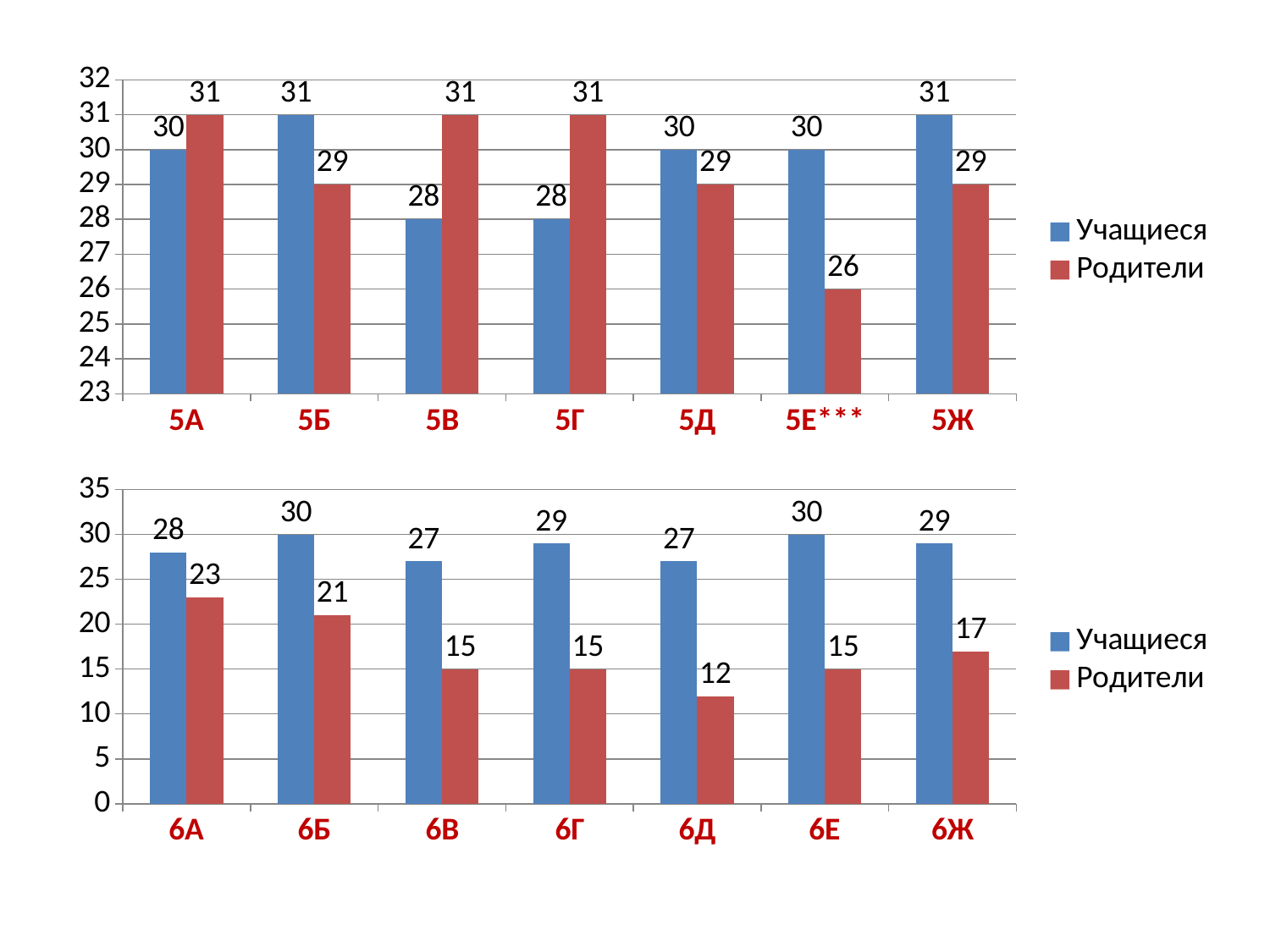
How many series does the legend of the top chart list? 2 In the top chart, which class has the lowest value for Родители? 5Е*** In the bottom chart, what is the value for Учащиеся in class 6Ж? 29 In the top chart, what is the value for Родители in class 5Е***? 26 In the top chart, which is larger for class 5Б: Учащиеся or Родители? Учащиеся In the bottom chart, what is the value for Родители in class 6Д? 12 In the top chart, what is the value for Учащиеся in class 5В? 28 In the top chart, what is the difference between Родители and Учащиеся for class 5Г? 3 How many classes are shown on the x axis of the bottom chart? 7 In the bottom chart, which class has the highest value for Родители? 6А In the bottom chart, what is the difference between Учащиеся and Родители for class 6Б? 9 What type of chart is the bottom chart? Bar chart